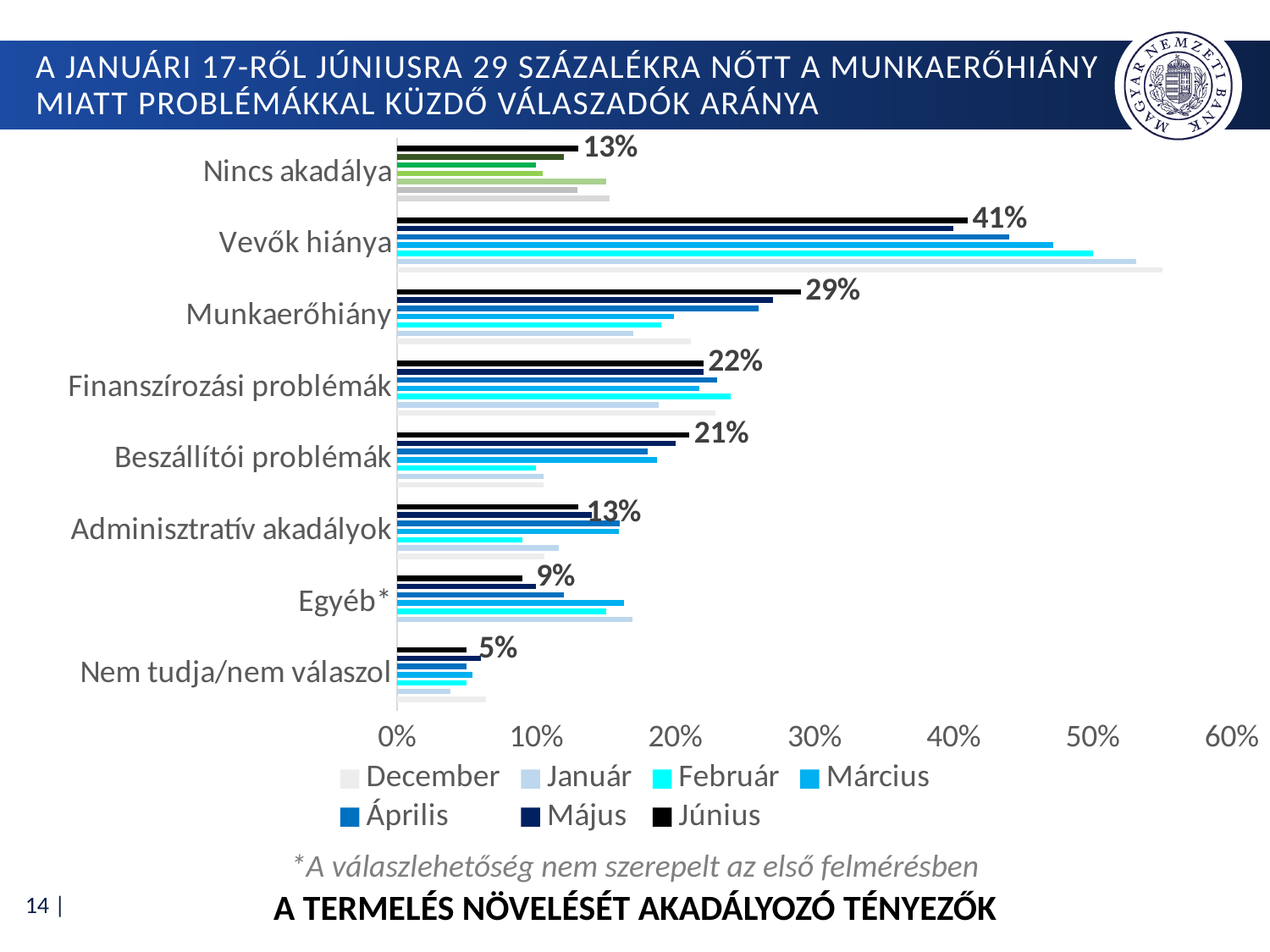
What is the Június value for Vevők hiánya? 41% How many series does the legend list? 7 What kind of chart is shown on the slide? Bar chart Which category has the highest Június value? Vevők hiánya What is the Június value for Munkaerőhiány? 29% What is the difference between the Június values for Vevők hiánya and Munkaerőhiány? 12 percentage points Which is larger in Június: Munkaerőhiány or Finanszírozási problémák? Munkaerőhiány How many categories are shown on the chart? 8 Which category has the lowest Június value? Nem tudja/nem válaszol What is the Június value for Egyéb*? 9% Is the December value for Vevők hiánya greater or less than 50%? greater What is the Június value for Nem tudja/nem válaszol? 5%